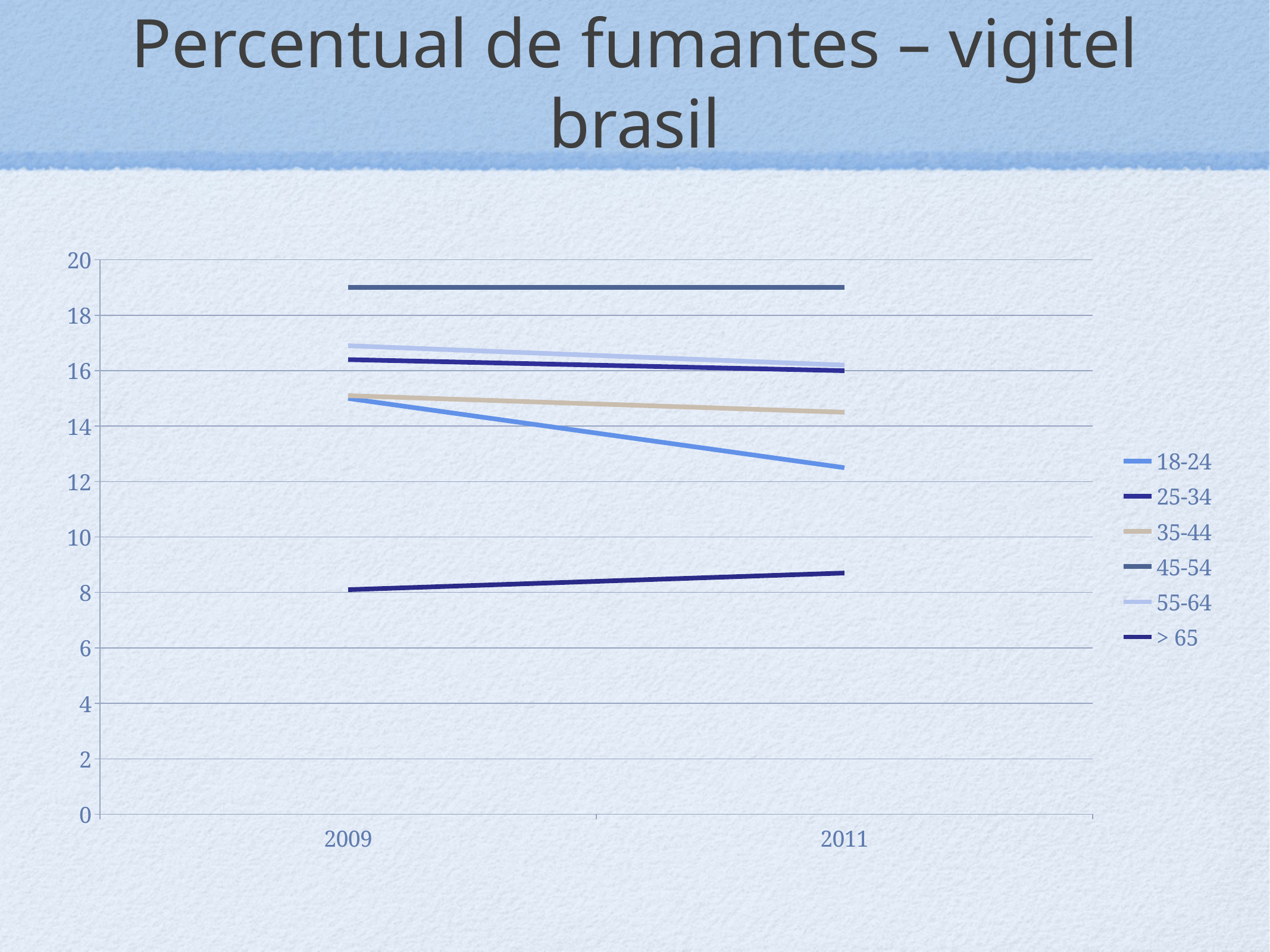
In 2011, which is larger: the value for 45-54 or the value for 18-24? 45-54 Does the value for the 18-24 group rise or fall from 2009 to 2011? fall Which age group has the highest value in 2011? 45-54 Is the value for the 45-54 group in 2009 greater or less than 18? greater Is the value for the 18-24 group in 2011 greater or less than 14? less Is the value for the > 65 group in 2009 greater or less than 10? less Does the value for the > 65 group rise or fall from 2009 to 2011? rise How many years are shown on the x axis? 2 What is the title of the slide? Percentual de fumantes – vigitel brasil How many series does the legend list? 6 Which age group has the lowest value in 2009? > 65 What kind of chart is shown on the slide? line chart